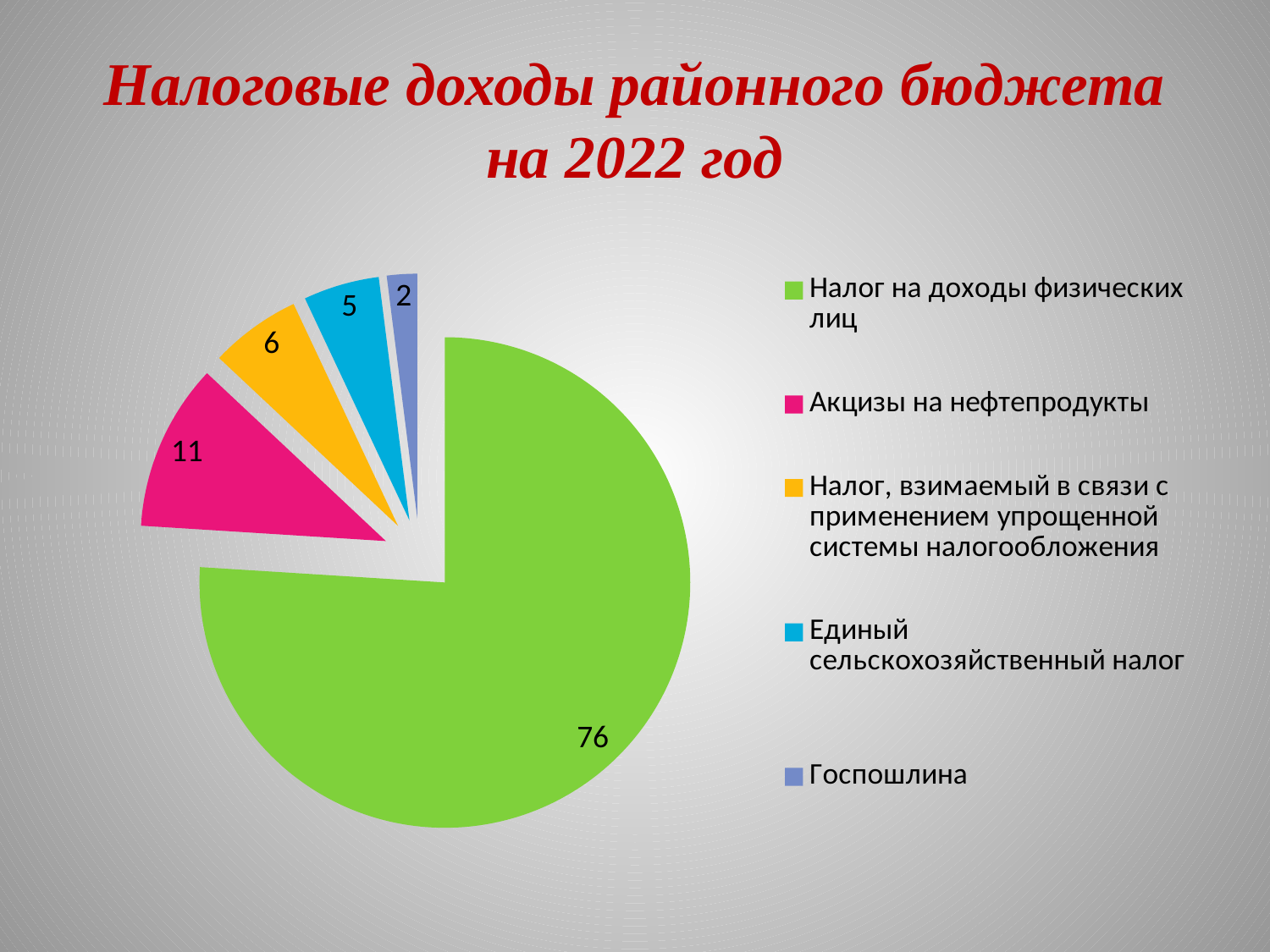
What is the value for Госпошлина? 2 What is the difference between the values for Налог на доходы физических лиц and Акцизы на нефтепродукты? 65 What is the value for Налог, взимаемый в связи с применением упрощенной системы налогообложения? 6 Which category has the largest slice of the pie? Налог на доходы физических лиц How many categories does the pie chart have? 5 What is the value for Акцизы на нефтепродукты? 11 Which is larger, the value for Единый сельскохозяйственный налог or the value for Госпошлина? Единый сельскохозяйственный налог Which category has the smallest slice of the pie? Госпошлина What is the title of the slide? Налоговые доходы районного бюджета на 2022 год What is the value for Единый сельскохозяйственный налог? 5 What type of chart is shown on the slide? pie chart What is the value for Налог на доходы физических лиц? 76